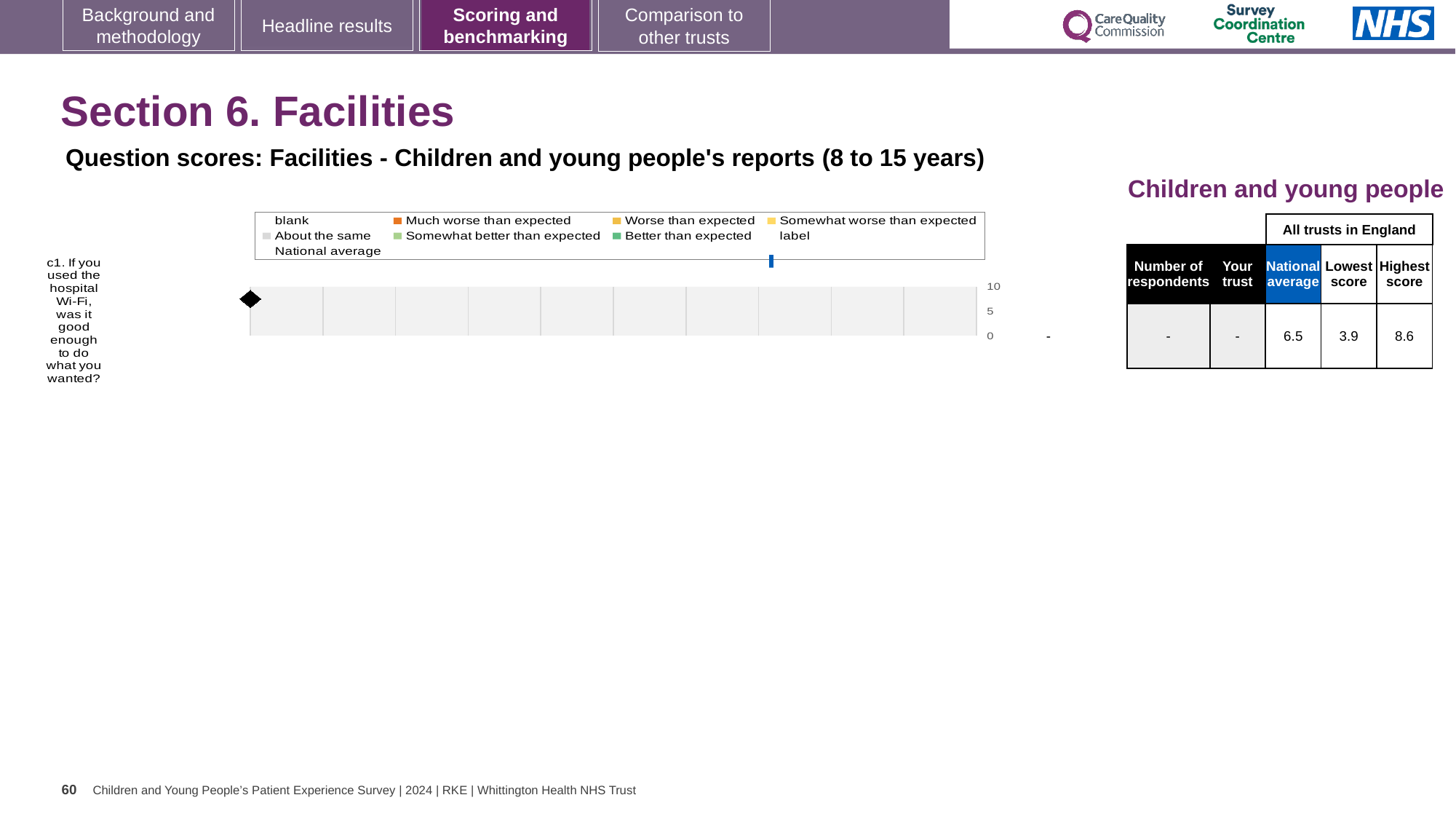
What is the difference between the Highest score and the Lowest score shown in the table for question c1? 4.7 Which question is plotted on the chart? c1. If you used the hospital Wi-Fi, was it good enough to do what you wanted? How many question categories are plotted on the chart? 1 According to the table next to the chart, what is the Lowest score for question c1? 3.9 According to the table next to the chart, what is the Highest score for question c1? 8.6 What kind of chart is shown on the slide? bar chart Which is larger in the table for question c1, the National average or the Lowest score? National average What value is shown for Your trust in the table for question c1? - According to the table next to the chart, what is the National average score for question c1? 6.5 What is the highest value shown on the chart's axis? 10 How many entries does the chart legend list? 9